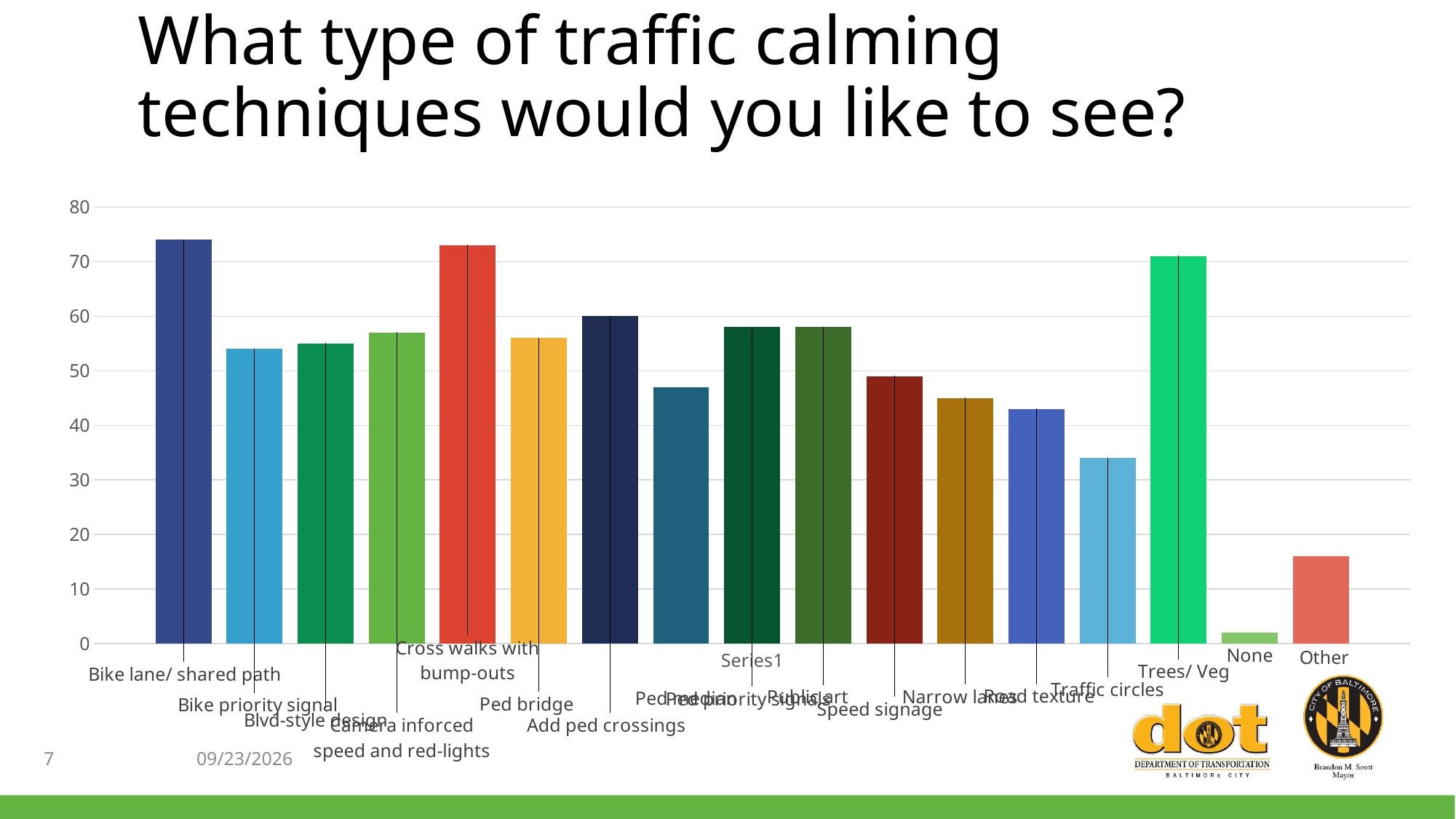
Is the value for Traffic circles greater or less than 40? less What series name is shown in the chart's legend? Series1 What is the title of the slide's chart? What type of traffic calming techniques would you like to see? Is the value for Road texture greater or less than 40? greater Is the value for Bike lane/ shared path greater or less than 70? greater Which is larger, the value for Other or the value for None? Other How many categories (bars) does the chart show? 17 What kind of chart is shown on the slide? bar chart Which is larger, the value for Bike lane/ shared path or the value for Traffic circles? Bike lane/ shared path Which category has the lowest value? None